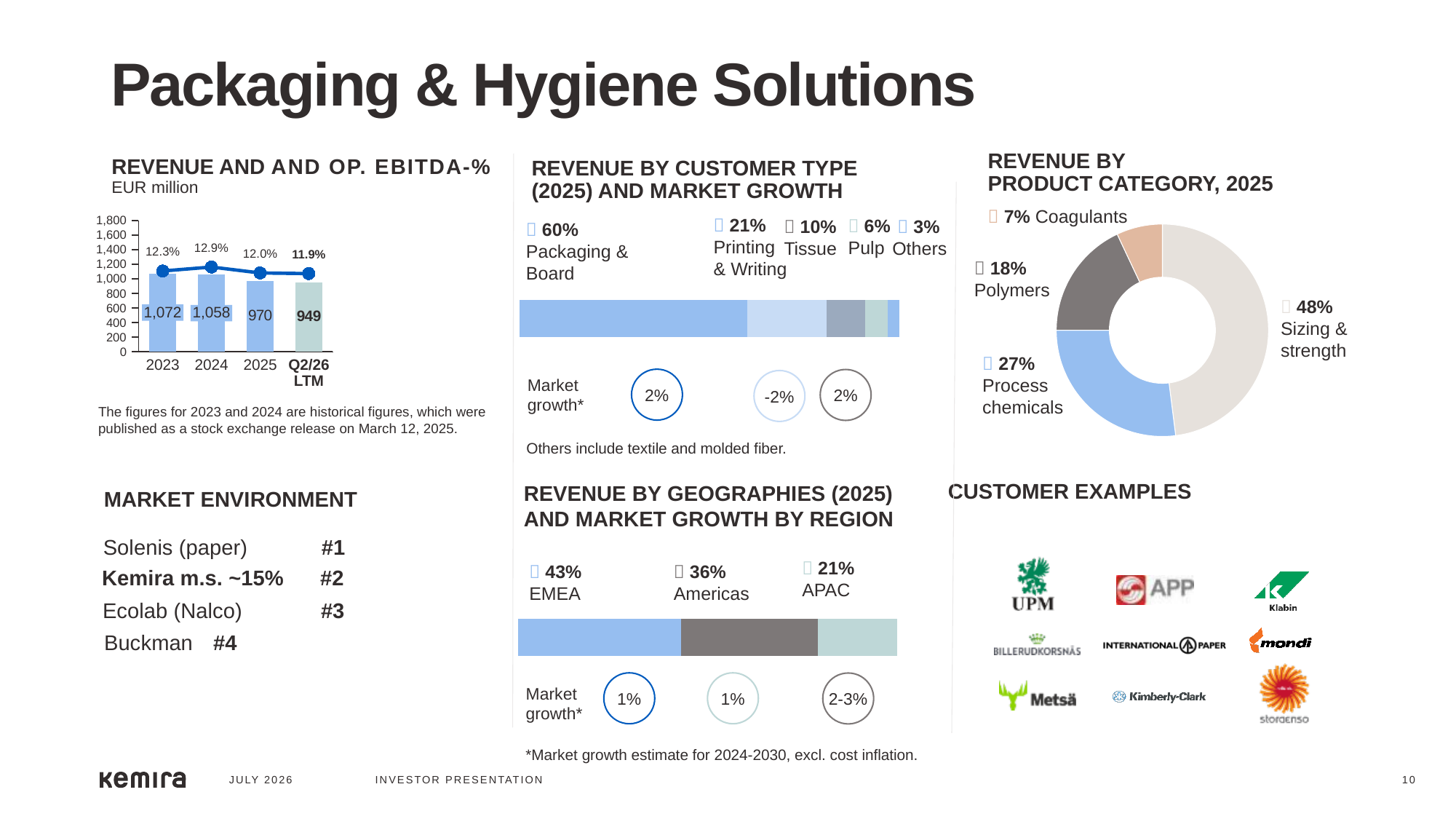
In the 'Revenue by customer type (2025)' chart, what is the market growth for Printing & Writing? -2% In the 'Revenue by product category, 2025' chart, what share is Sizing & strength? 48% In the 'Revenue by product category, 2025' chart, what is the difference between the Process chemicals and Polymers shares? 9% In the 'Revenue by product category, 2025' chart, which category has the smallest share? Coagulants In the 'Revenue and Op. EBITDA-%' chart, what is the difference in revenue between 2023 and 2025? 102 In the 'Revenue and Op. EBITDA-%' chart, what was revenue in 2023? 1,072 In the 'Revenue and Op. EBITDA-%' chart, what is the revenue for Q2/26 LTM? 949 In the 'Revenue by customer type (2025)' chart, what share of revenue comes from Tissue? 10% In the 'Revenue by geographies (2025)' chart, which region is larger, Americas or APAC? Americas In the 'Revenue and Op. EBITDA-%' chart, does revenue rise or fall from 2023 to Q2/26 LTM? fall In the 'Revenue and Op. EBITDA-%' chart, how many periods are shown on the x axis? 4 In the 'Revenue and Op. EBITDA-%' chart, which year has the highest Op. EBITDA-%? 2024